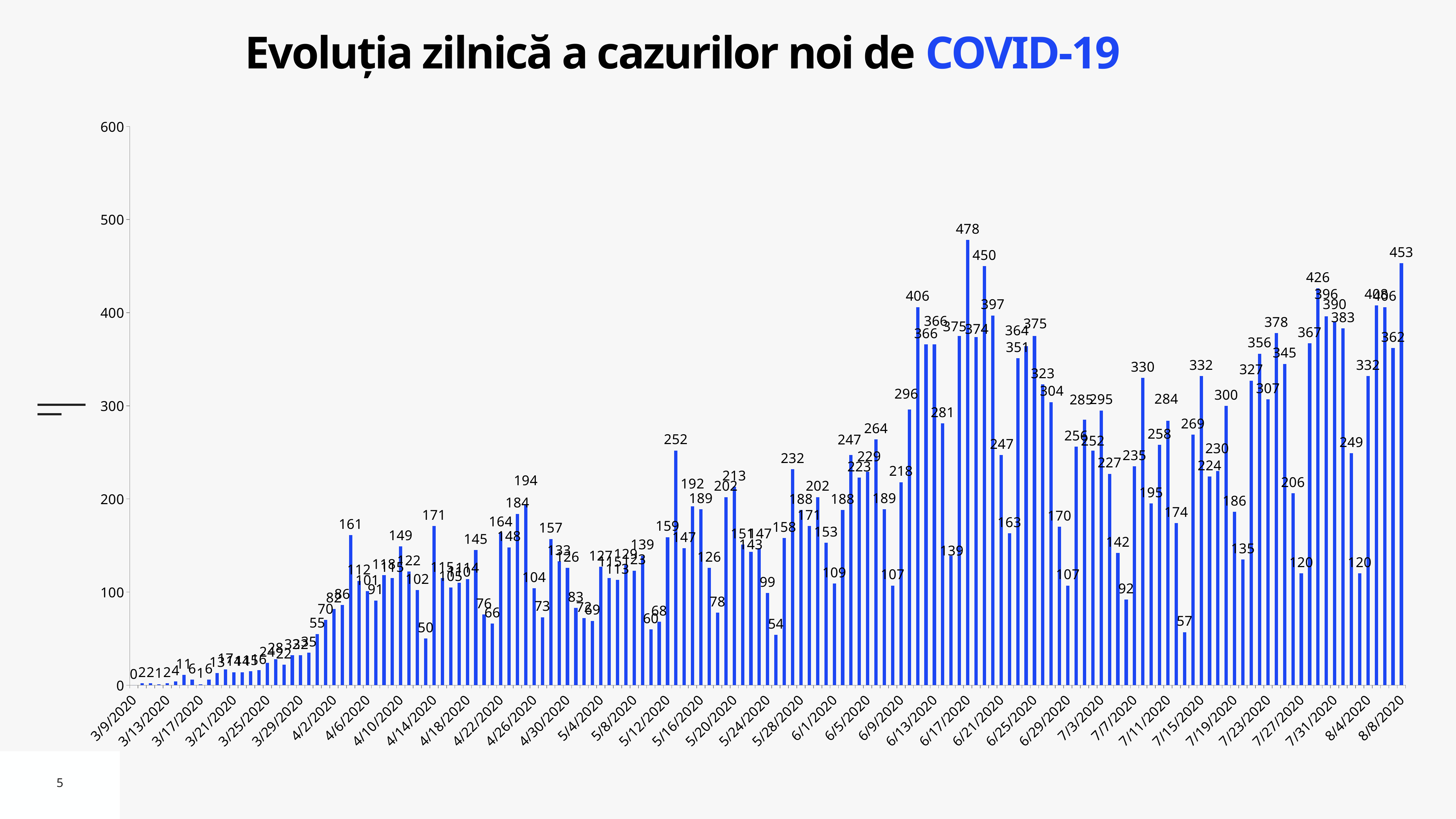
What is the second highest daily value shown on the chart? 450 What is the title of the chart? Evoluția zilnică a cazurilor noi de COVID-19 What is the maximum value shown on the vertical axis? 600 What kind of chart is shown on the slide? bar chart What is the value for the first date, 3/9/2020? 0 What is the lowest value shown on the chart? 0 Is the value for 8/8/2020 greater or less than 400? greater What is the highest daily value shown on the chart? 478 Overall, do the daily values rise or fall from March to August? rise What is the value for the last date, 8/8/2020? 453 What is the difference between the highest value (478) and the value for 8/8/2020 (453)? 25 Which is larger, the highest bar (478) or the bar for 8/8/2020? 478